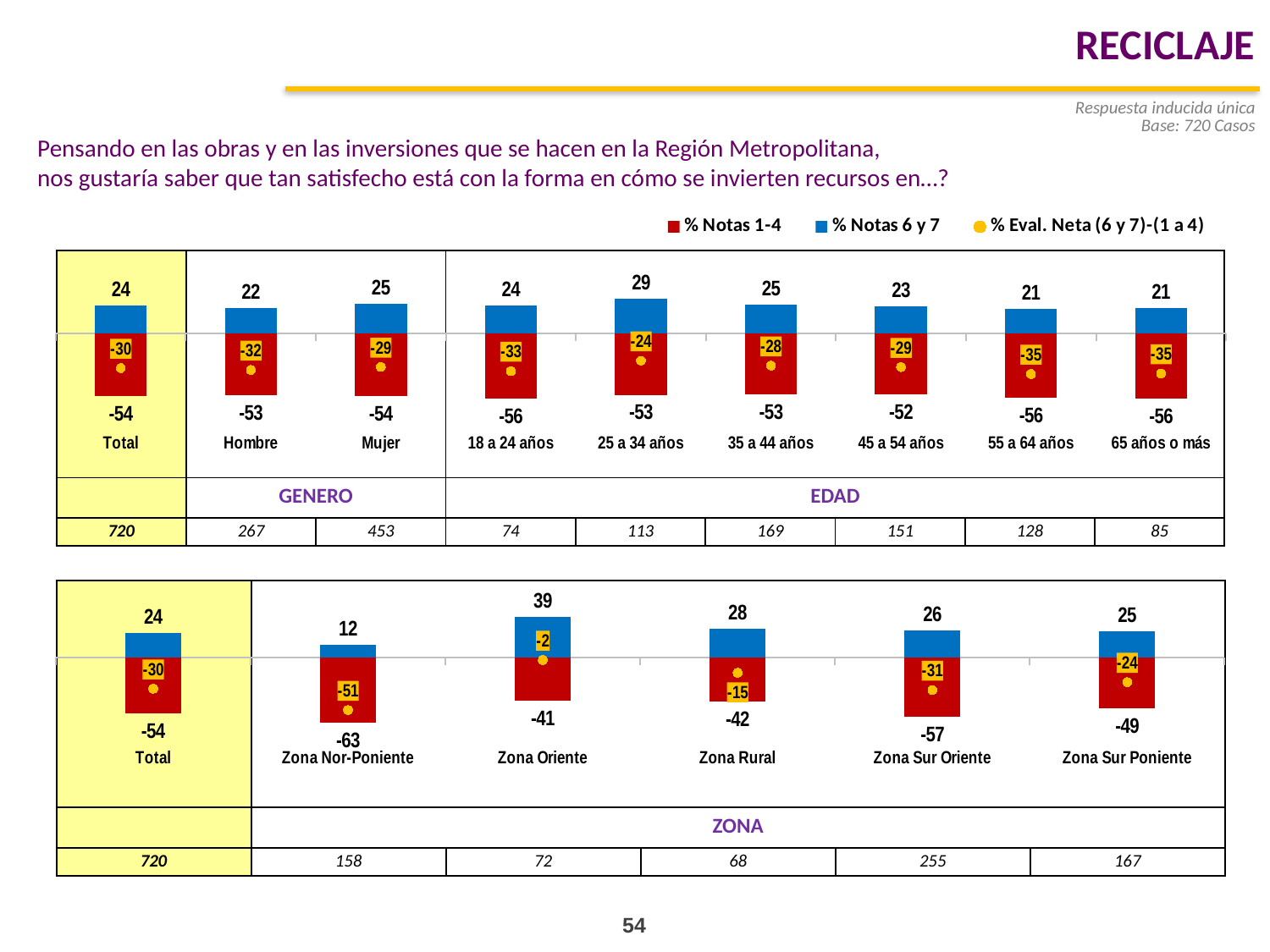
In the bottom chart, which zone has the lowest % Notas 6 y 7 value? Zona Nor-Poniente In the top chart, which age group has the highest % Notas 6 y 7 value? 25 a 34 años In the bottom chart, what is the % Notas 1-4 value for Zona Nor-Poniente? -63 How many series does the legend list? 3 In the bottom chart, what is the % Eval. Neta value for Zona Rural? -15 In the top chart, what is the % Notas 6 y 7 value for Hombre? 22 In the bottom chart, which is larger, the % Notas 6 y 7 value for Zona Sur Oriente or for Zona Sur Poniente? Zona Sur Oriente In the bottom chart, what is the % Notas 6 y 7 value for Zona Oriente? 39 In the top chart, what is the difference between the % Notas 6 y 7 values for Mujer and Hombre? 3 In the top chart, what is the % Eval. Neta value for 25 a 34 años? -24 What kind of chart is the bottom chart? bar chart In the top chart, what is the % Notas 1-4 value for 18 a 24 años? -56